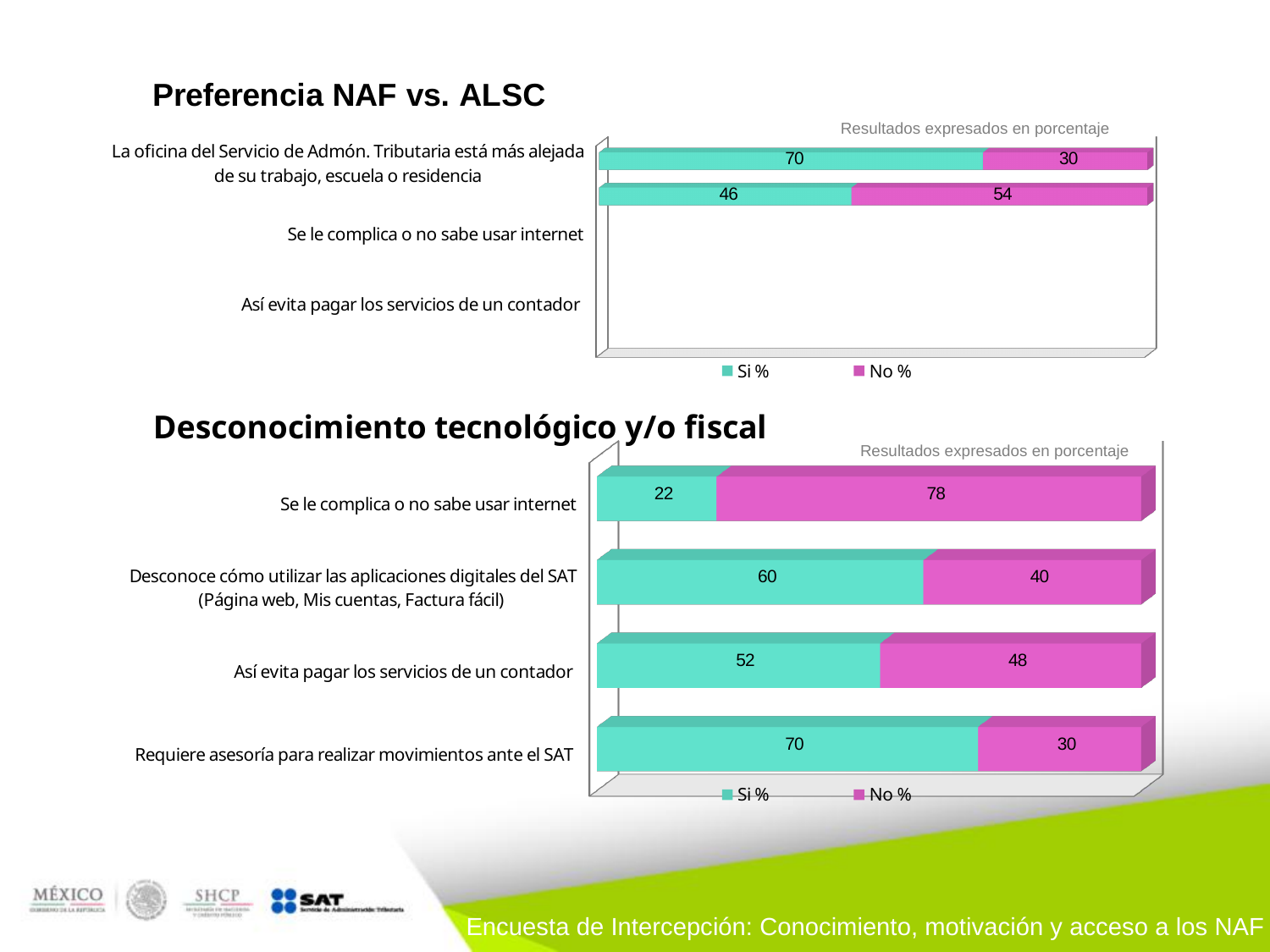
In the 'Desconocimiento tecnológico y/o fiscal' chart, what is the total of the stacked bar for 'Desconoce cómo utilizar las aplicaciones digitales del SAT'? 100 In the 'Desconocimiento tecnológico y/o fiscal' chart, how much larger is the No % value than the Si % value for 'Se le complica o no sabe usar internet'? 56 In the 'Desconocimiento tecnológico y/o fiscal' chart, what is the Si % value for 'Se le complica o no sabe usar internet'? 22 In the 'Desconocimiento tecnológico y/o fiscal' chart, which category has the highest Si % value? Requiere asesoría para realizar movimientos ante el SAT In the 'Preferencia NAF vs. ALSC' chart, what is the Si % value for 'La oficina del Servicio de Admón. Tributaria está más alejada de su trabajo, escuela o residencia'? 70 In the 'Desconocimiento tecnológico y/o fiscal' chart, for 'Así evita pagar los servicios de un contador', which is larger: Si % or No %? Si % In the 'Desconocimiento tecnológico y/o fiscal' chart, which category has the lowest Si % value? Se le complica o no sabe usar internet In the 'Desconocimiento tecnológico y/o fiscal' chart, what is the Si % value for 'Requiere asesoría para realizar movimientos ante el SAT'? 70 In the 'Desconocimiento tecnológico y/o fiscal' chart, what is the No % value for 'Desconoce cómo utilizar las aplicaciones digitales del SAT'? 40 How many series does the legend of the 'Desconocimiento tecnológico y/o fiscal' chart list? 2 What kind of chart is the 'Desconocimiento tecnológico y/o fiscal' chart? Stacked bar chart How many categories are shown in the 'Desconocimiento tecnológico y/o fiscal' chart? 4